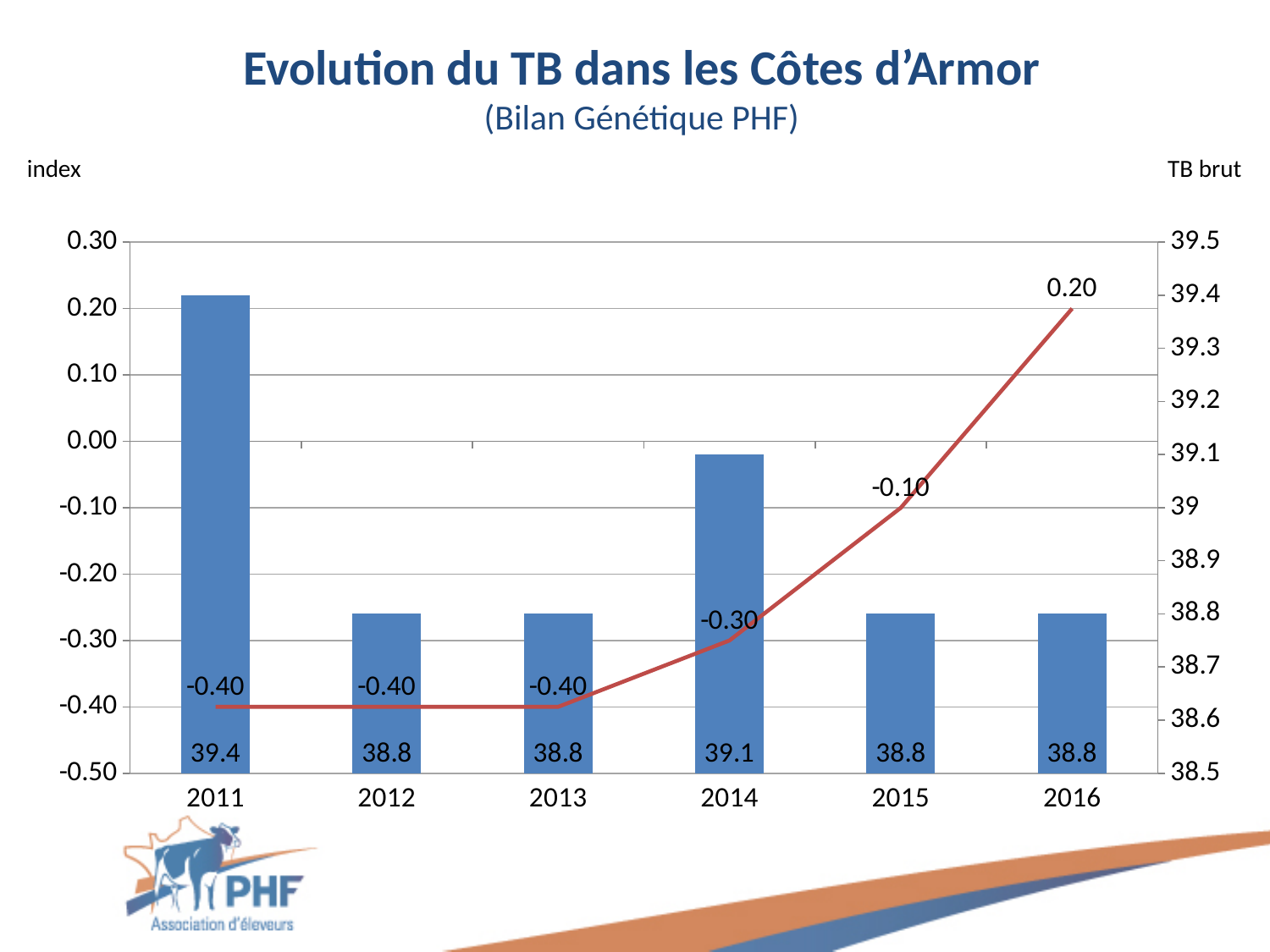
What is the TB brut value (bar label) for 2011? 39.4 What is the index value (line label) for 2015? -0.10 What is the difference between the TB brut values for 2011 and 2012? 0.6 Which year has the highest index value on the line? 2016 Is the TB brut bar for 2014 larger or smaller than the bar for 2015? larger What is the TB brut value (bar label) for 2014? 39.1 What kind of chart is this? Combined bar and line chart What is the index value (line label) for 2016? 0.20 Which year has the lowest index value on the line, among 2014, 2015 and 2016? 2014 How many years are shown on the x axis? 6 Does the index line rise or fall from 2013 to 2016? rise Which year has the highest TB brut bar? 2011